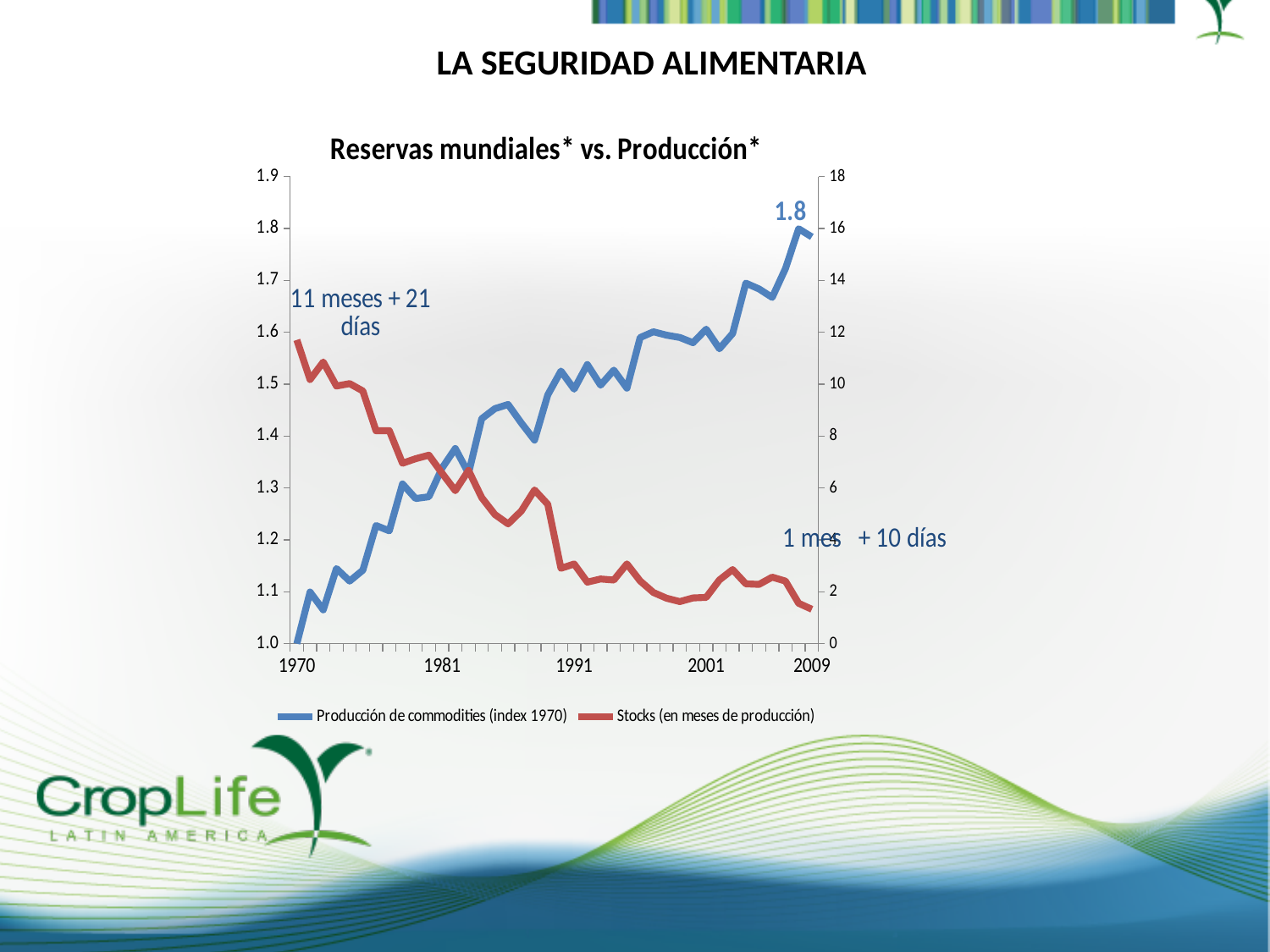
Is the value for Stocks (en meses de producción) in 1970 greater or less than 10? greater What colour is the Stocks (en meses de producción) line? red What is the value of Producción de commodities (index 1970) in 2009? 1.8 What kind of chart is shown on the slide? line chart Does the Producción de commodities (index 1970) line rise or fall from 1970 to 2009? rise In which year is Producción de commodities (index 1970) at its highest? 2008 Is the value for Producción de commodities (index 1970) in 1991 greater or less than 1.4? greater In which year is Stocks (en meses de producción) at its highest? 1970 Does the Stocks (en meses de producción) line rise or fall from 1970 to 2009? fall What is the title of the chart? Reservas mundiales* vs. Producción* How many series does the legend list? 2 Is the value for Stocks (en meses de producción) in 2009 greater or less than 2? less